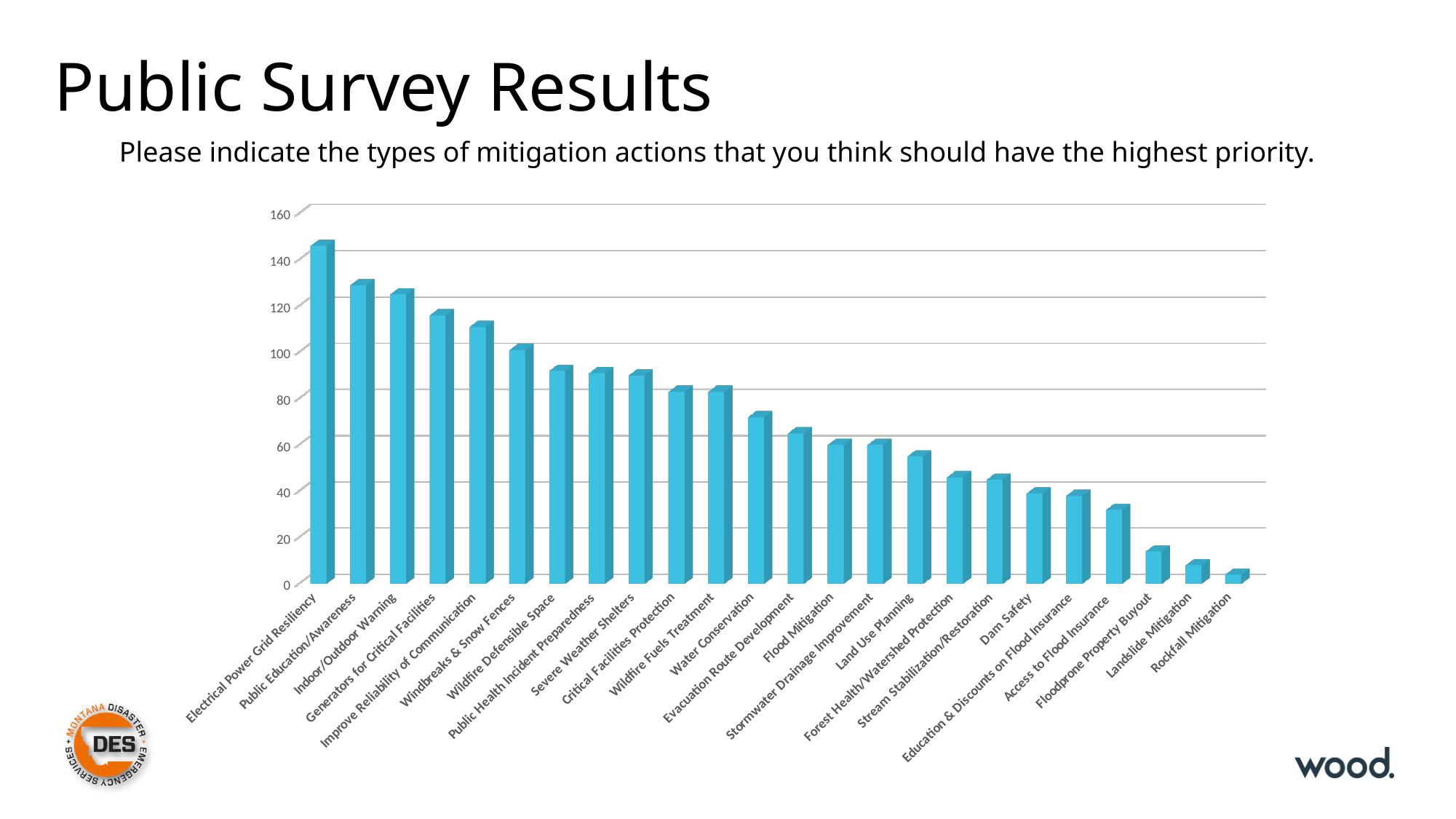
Is the value for Public Education/Awareness greater or less than 120? greater Which mitigation action received the lowest number of responses? Rockfall Mitigation Is the value for Access to Flood Insurance greater or less than 40? less Is the value for Water Conservation greater or less than 80? less Which mitigation action received the highest number of responses? Electrical Power Grid Resiliency Which has a larger value, Public Education/Awareness or Water Conservation? Public Education/Awareness What kind of chart is shown on the slide? bar chart How many mitigation action categories are plotted on the chart? 24 Do the bar values rise or fall moving from left to right along the x axis? fall